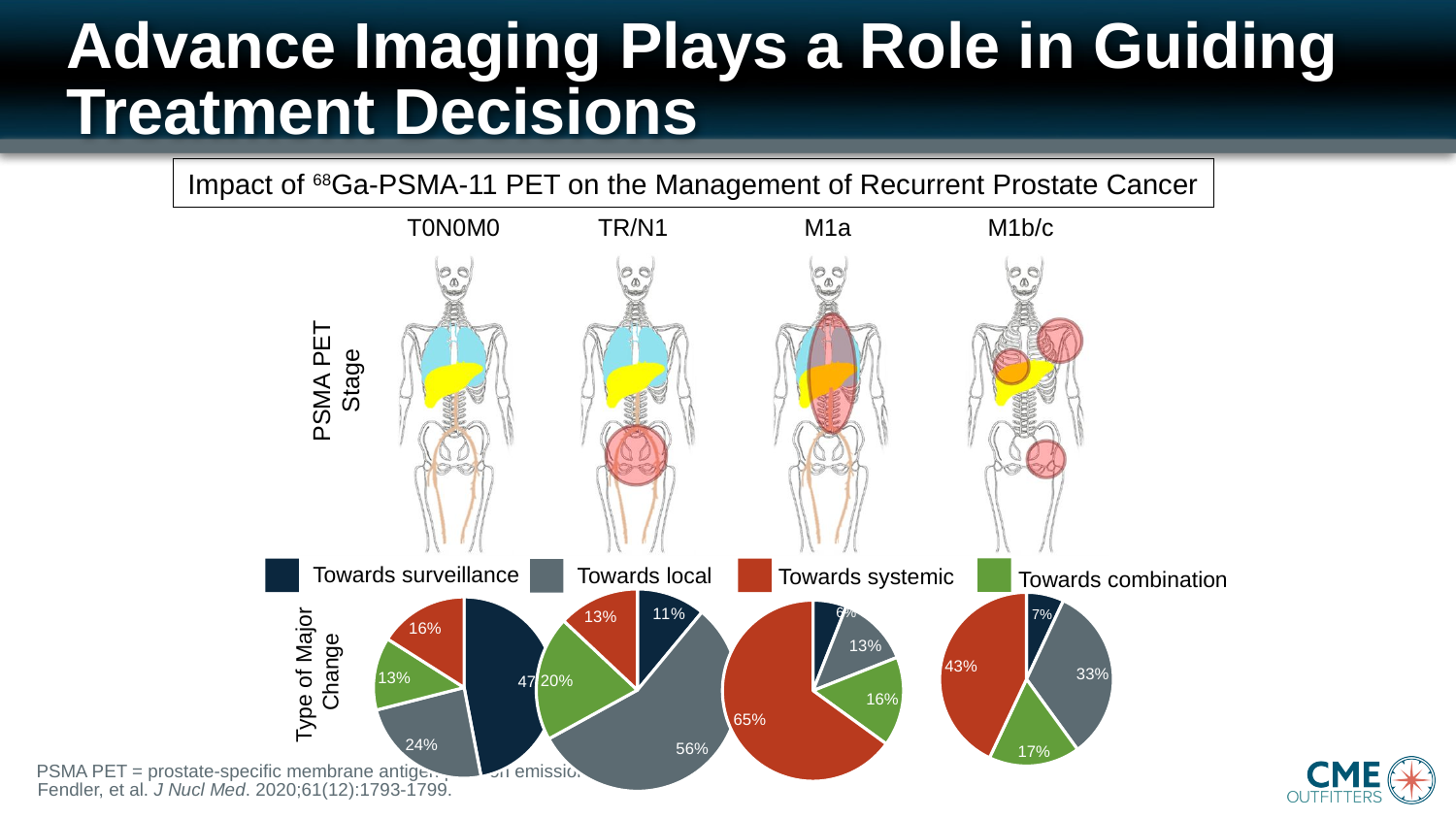
In the M1a pie chart, what is the share for Towards systemic? 65% In the TR/N1 pie chart, which type of major change has the smallest share? Towards surveillance Which colour represents Towards systemic in the legend? Red In the T0N0M0 pie chart, what is the share for Towards local? 24% In the M1a pie chart, what is the difference between the Towards systemic share and the Towards combination share? 49% In the M1b/c pie chart, which is larger, Towards systemic or Towards local? Towards systemic In the M1b/c pie chart, what is the share for Towards combination? 17% In the TR/N1 pie chart, what is the share for Towards local? 56% What kind of charts are shown at the bottom of the slide? Pie charts How many categories does the legend above the pie charts list? 4 In the T0N0M0 pie chart, which type of major change has the largest share? Towards surveillance How many pie charts are on the slide? 4